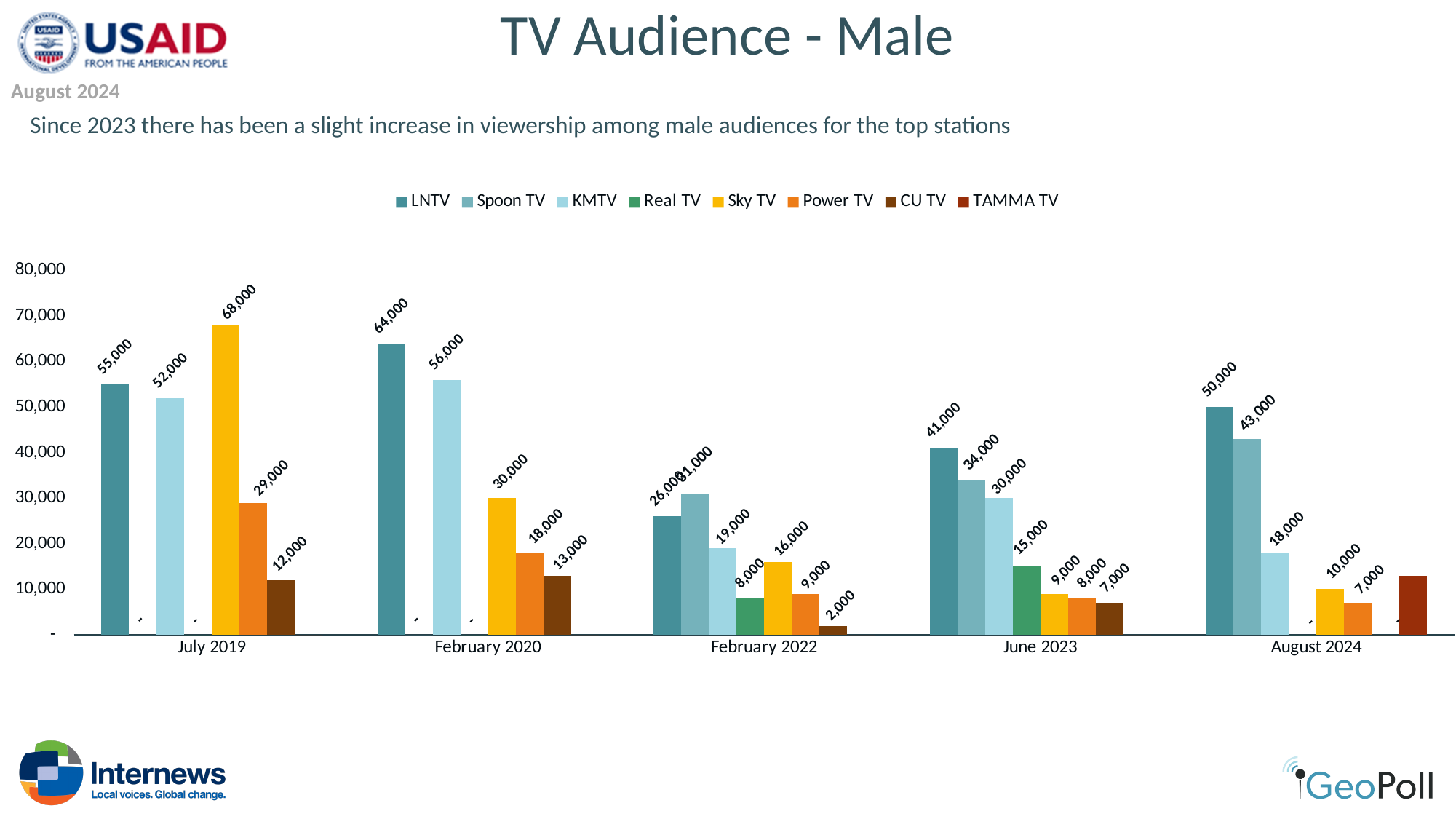
What kind of chart is shown on the slide? Bar chart Does LNTV's male audience rise or fall from February 2022 to August 2024? Rise What was the male audience for LNTV in August 2024? 50,000 How many time periods are shown along the x axis? 5 Which station had the highest male audience in February 2020? LNTV What was the male audience for Real TV in June 2023? 15,000 Is the value for TAMMA TV in August 2024 greater or less than 10,000? greater Which station had the lowest male audience in February 2022? CU TV In February 2022, which had the larger male audience, LNTV or Spoon TV? Spoon TV What was the male audience for Sky TV in July 2019? 68,000 How many TV stations does the legend list? 8 By how much did LNTV's male audience increase from June 2023 to August 2024? 9,000